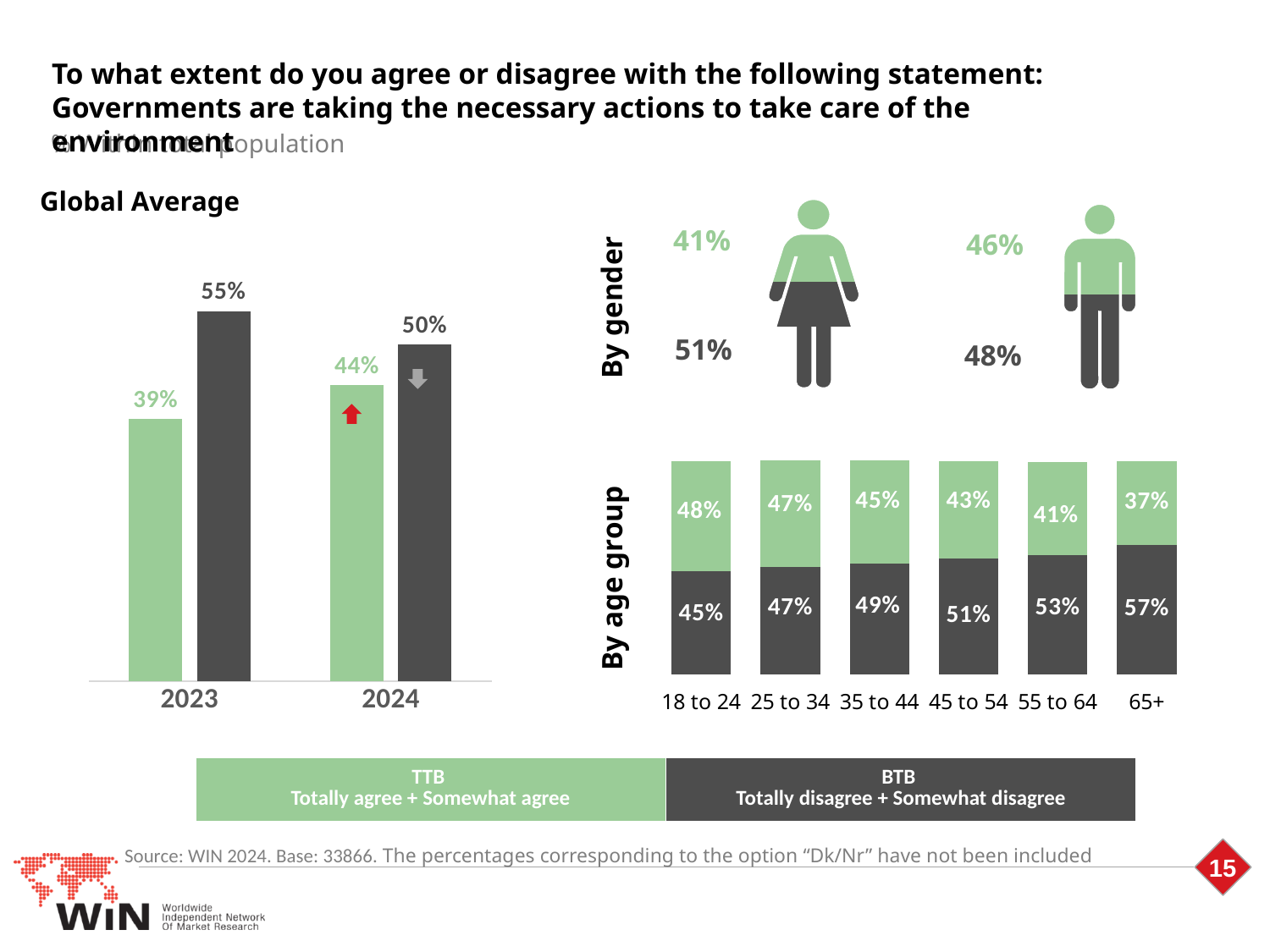
In the By gender section, what is the TTB (agree) value for men? 46% In the By age group chart, what is the difference between the BTB and TTB values for the 65+ age group? 20 percentage points In the Global Average chart, by how many percentage points did the BTB value fall from 2023 to 2024? 5 percentage points In the Global Average chart, what is the BTB (Totally disagree + Somewhat disagree) value for 2023? 55% How many age groups are shown in the By age group chart? 6 In the By age group chart, which age group has the highest BTB (disagree) value? 65+ What type of chart is the Global Average chart? bar chart In the Global Average chart, what is the TTB (Totally agree + Somewhat agree) value for 2024? 44% In the By age group chart, what is the TTB (agree) value for the 35 to 44 age group? 45% In the Global Average chart, did the TTB value rise or fall from 2023 to 2024? rise In the By age group chart, which age group has the lowest TTB (agree) value? 65+ In the Global Average chart, which is larger in 2024, the TTB value or the BTB value? BTB